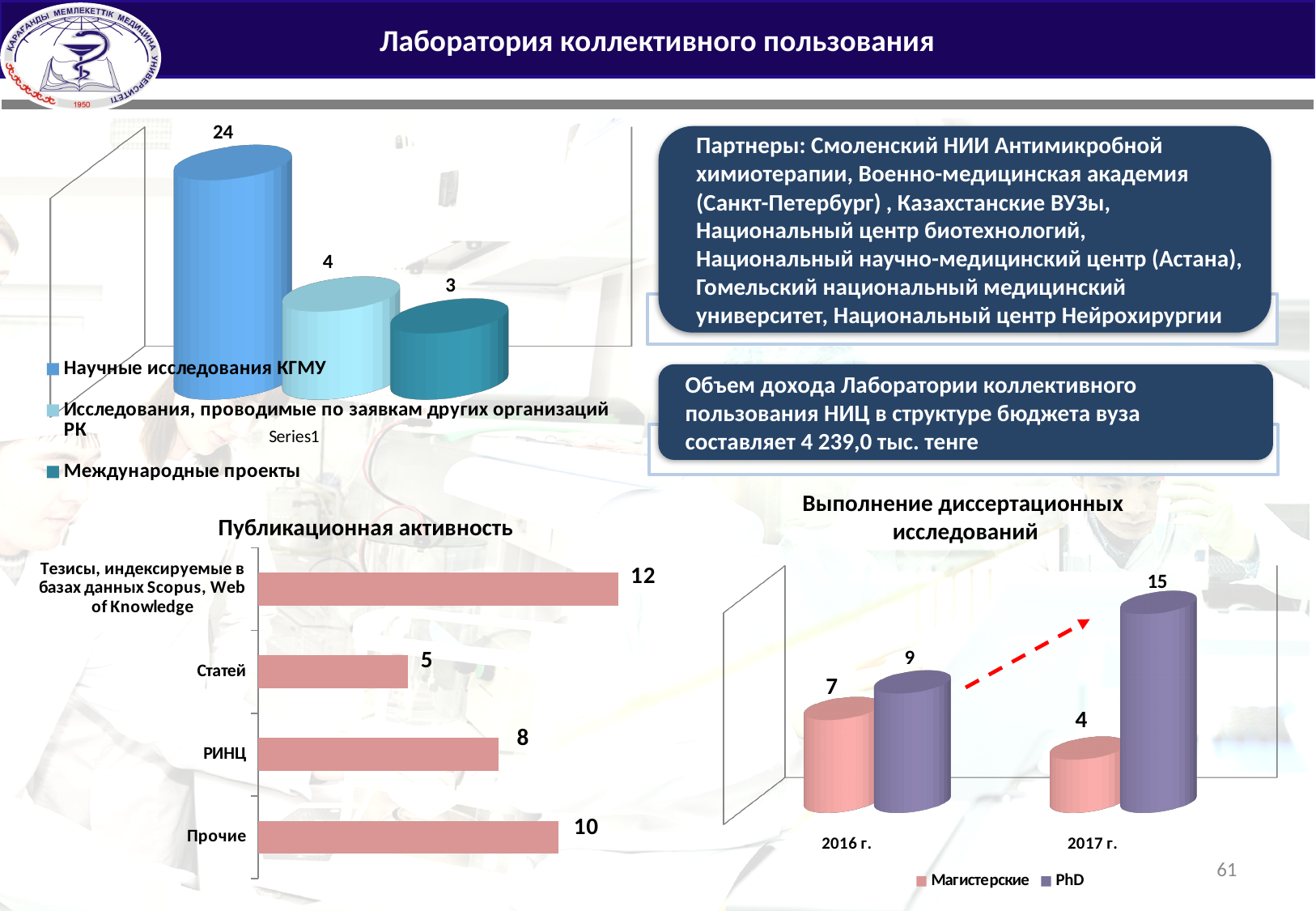
In the top-left chart, what is the difference between Исследования, проводимые по заявкам других организаций РК and Международные проекты? 1 In the 'Публикационная активность' chart, what is the difference between Прочие and РИНЦ? 2 How many categories are shown in the 'Публикационная активность' chart? 4 In the 'Выполнение диссертационных исследований' chart, which is larger: Магистерские in 2016 г. or Магистерские in 2017 г.? Магистерские in 2016 г. In the 'Выполнение диссертационных исследований' chart, what is the Магистерские value for 2016 г.? 7 What type of chart is 'Публикационная активность'? bar chart In the 'Выполнение диссертационных исследований' chart, how many series does the legend list? 2 In the top-left chart, what is the value for Научные исследования КГМУ? 24 In the 'Публикационная активность' chart, which category has the lowest value? Статей In the 'Выполнение диссертационных исследований' chart, what is the PhD value for 2017 г.? 15 In the 'Публикационная активность' chart, what is the value for Статей? 5 In the 'Публикационная активность' chart, which category has the highest value? Тезисы, индексируемые в базах данных Scopus, Web of Knowledge